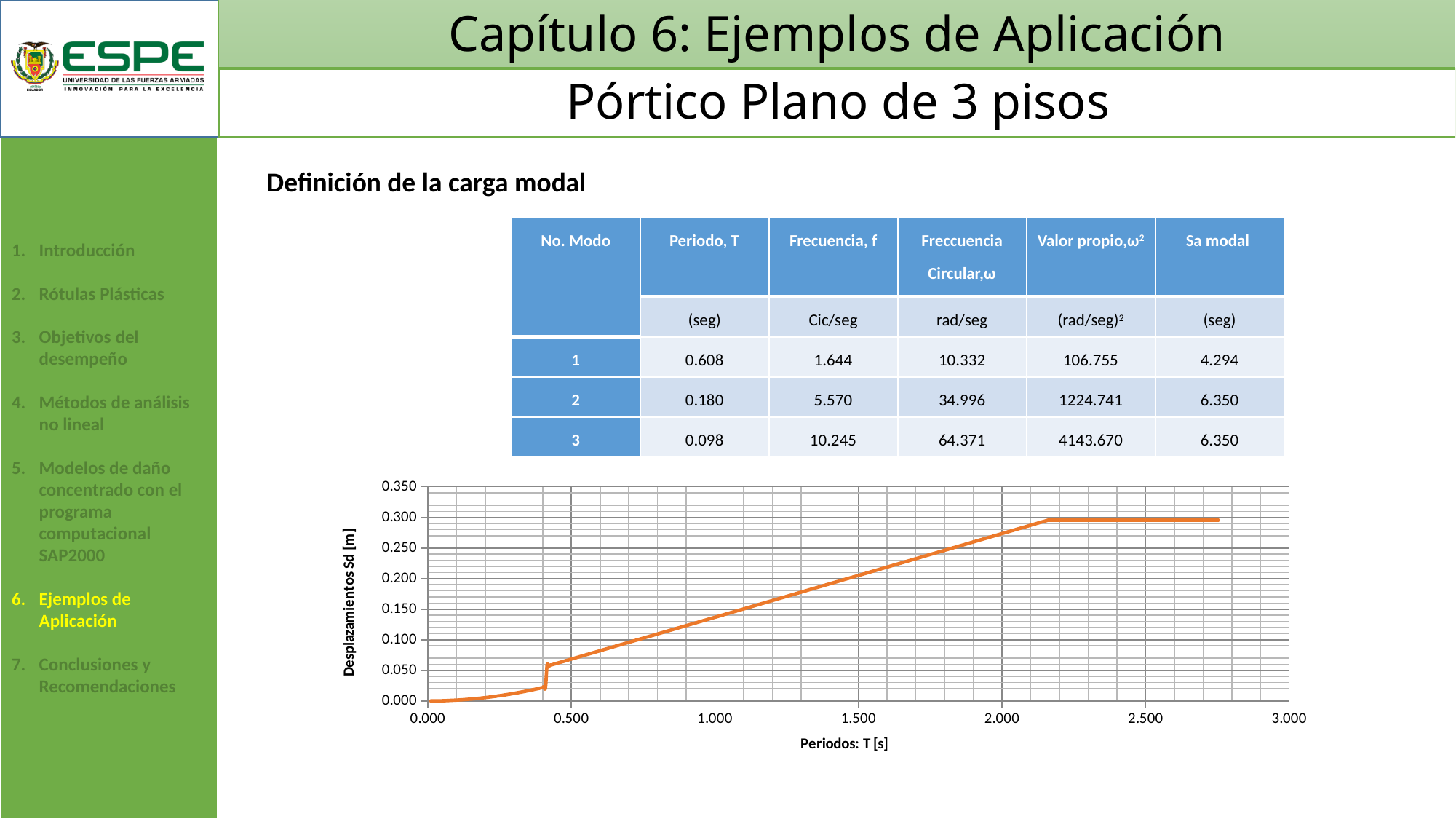
What is the label of the x axis of the line chart? Periodos: T [s] In the line chart, is the value of Sd at T = 1.500 greater or less than 0.250? less What kind of chart is shown at the bottom of the slide? line chart How many lines are plotted in the line chart? 1 In the line chart, do the values generally rise or fall as the period T increases from 0.000 to 2.000? rise In the line chart, is the value of Sd at T = 2.500 greater or less than 0.250? greater In the line chart, which is larger: the value of Sd at T = 1.000 or at T = 2.000? T = 2.000 In the line chart, is the value of Sd at T = 1.000 greater or less than 0.100? greater What is the label of the y axis of the line chart? Desplazamientos Sd [m]